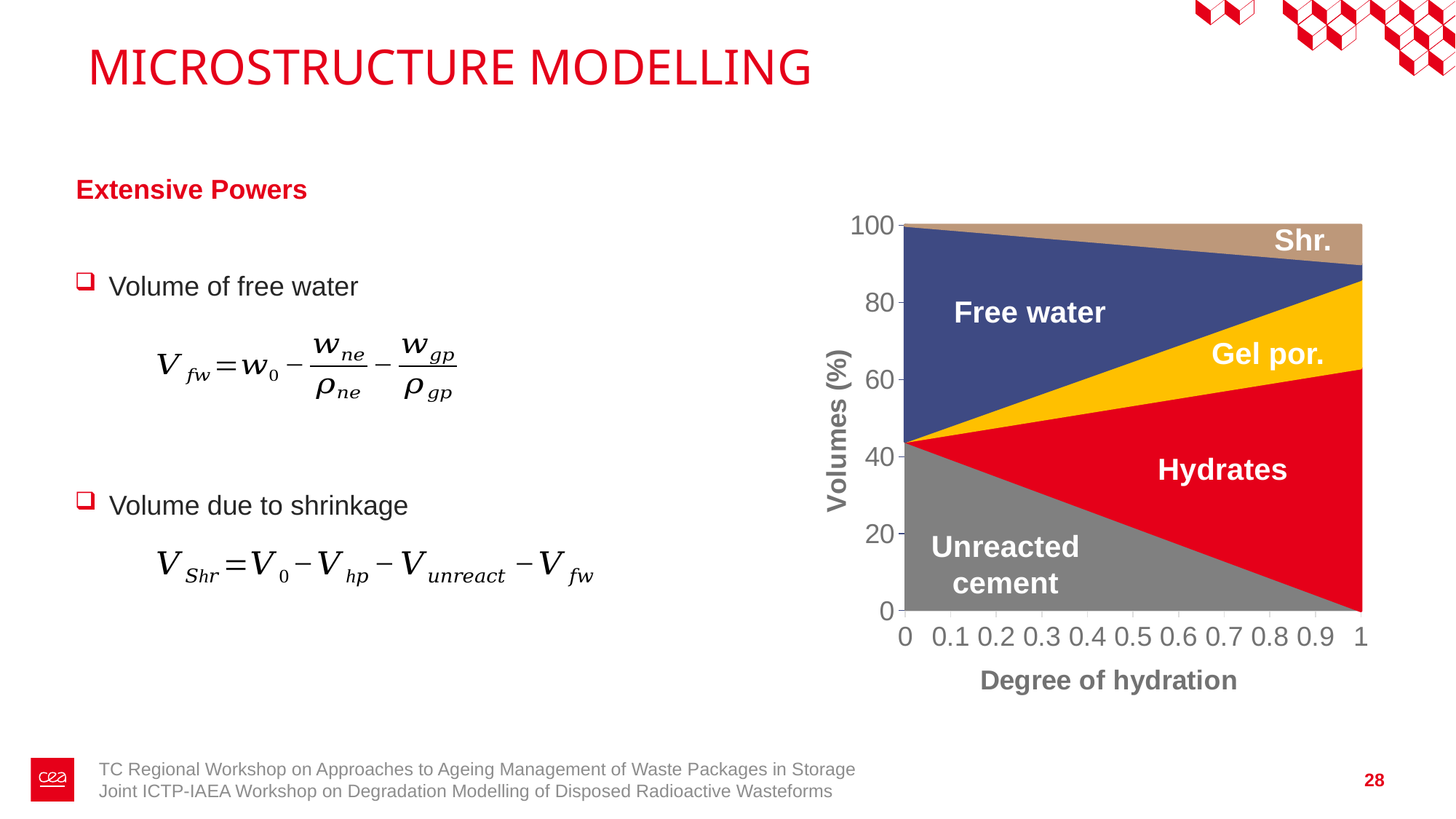
At a degree of hydration of 1, is the volume of hydrates greater or less than 40%? greater Which region occupies the largest volume at a degree of hydration of 1? Hydrates What kind of chart is shown on the slide? Stacked area chart Does the volume of hydrates rise or fall as the degree of hydration increases? Rise Does the volume of free water rise or fall as the degree of hydration increases? Fall What is the title of the y axis of the chart? Volumes (%) Does the volume of unreacted cement rise or fall as the degree of hydration increases? Fall What is the title of the x axis of the chart? Degree of hydration At a degree of hydration of 0, is the volume of unreacted cement greater or less than 40%? greater How many labelled regions does the chart show? 5 Which region occupies the largest volume at a degree of hydration of 0? Free water At a degree of hydration of 1, is the volume of unreacted cement greater or less than 20%? less